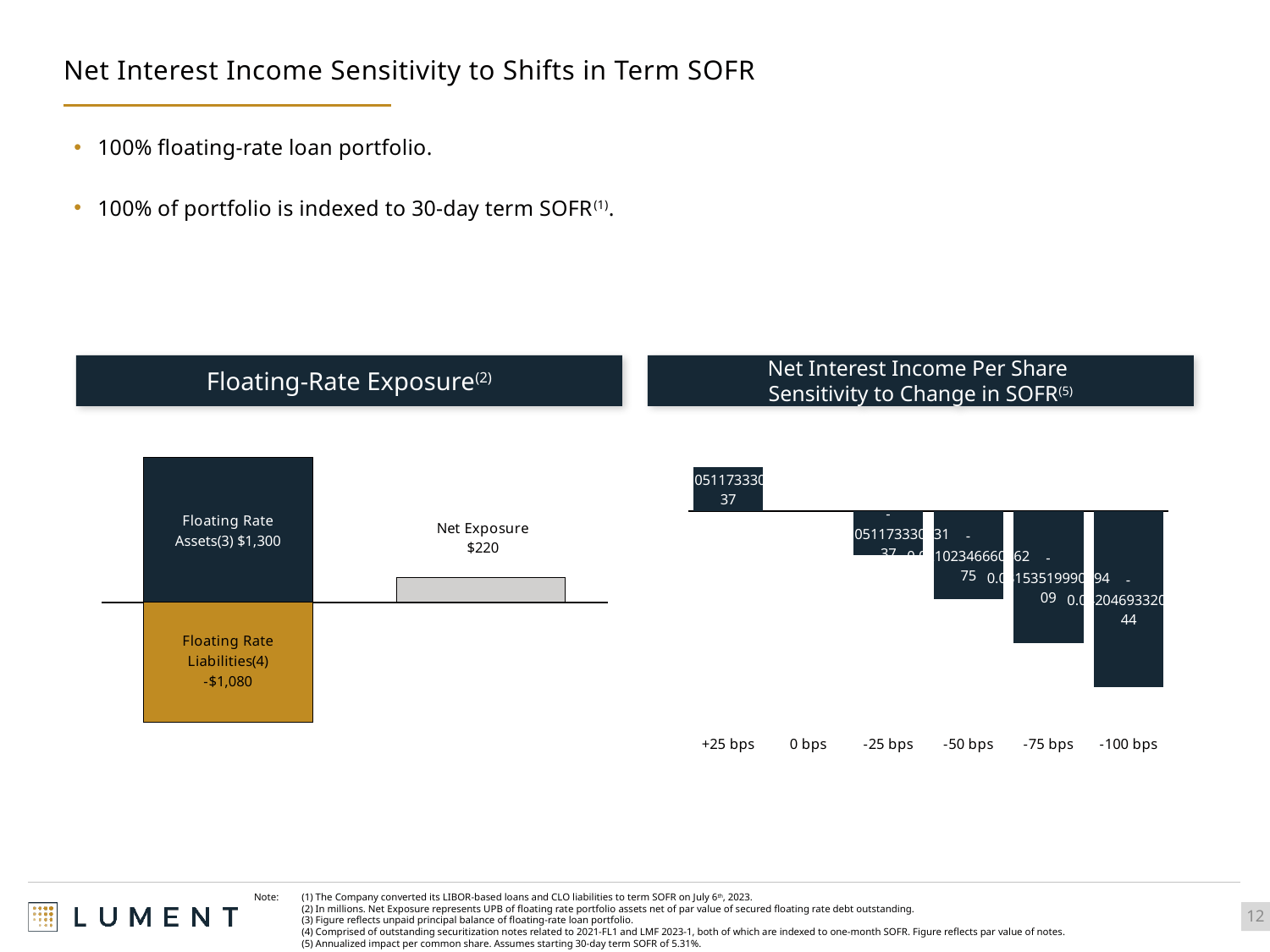
On the Net Interest Income Per Share Sensitivity chart, which category has the lowest (most negative) bar? -100 bps On the Floating-Rate Exposure chart, what is the value for Floating Rate Liabilities? -$1,080 On the Floating-Rate Exposure chart, what is the difference between Floating Rate Assets ($1,300) and the absolute value of Floating Rate Liabilities ($1,080)? $220 On the Floating-Rate Exposure chart, what is the value for Floating Rate Assets? $1,300 On the Net Interest Income Per Share Sensitivity chart, do the bars rise or fall moving from +25 bps to -100 bps along the x axis? Fall On the Net Interest Income Per Share Sensitivity chart, which category is the only one with a positive bar? +25 bps On the Floating-Rate Exposure chart, what is the Net Exposure value? $220 On the Net Interest Income Per Share Sensitivity chart, how many SOFR change categories are shown on the x axis? 6 What kind of chart is the Floating-Rate Exposure chart? Bar chart On the Floating-Rate Exposure chart, how many bars are plotted? 3 On the Floating-Rate Exposure chart, which bar is the only one plotted below the zero line? Floating Rate Liabilities On the Net Interest Income Per Share Sensitivity chart, which bar extends further below zero: -50 bps or -100 bps? -100 bps